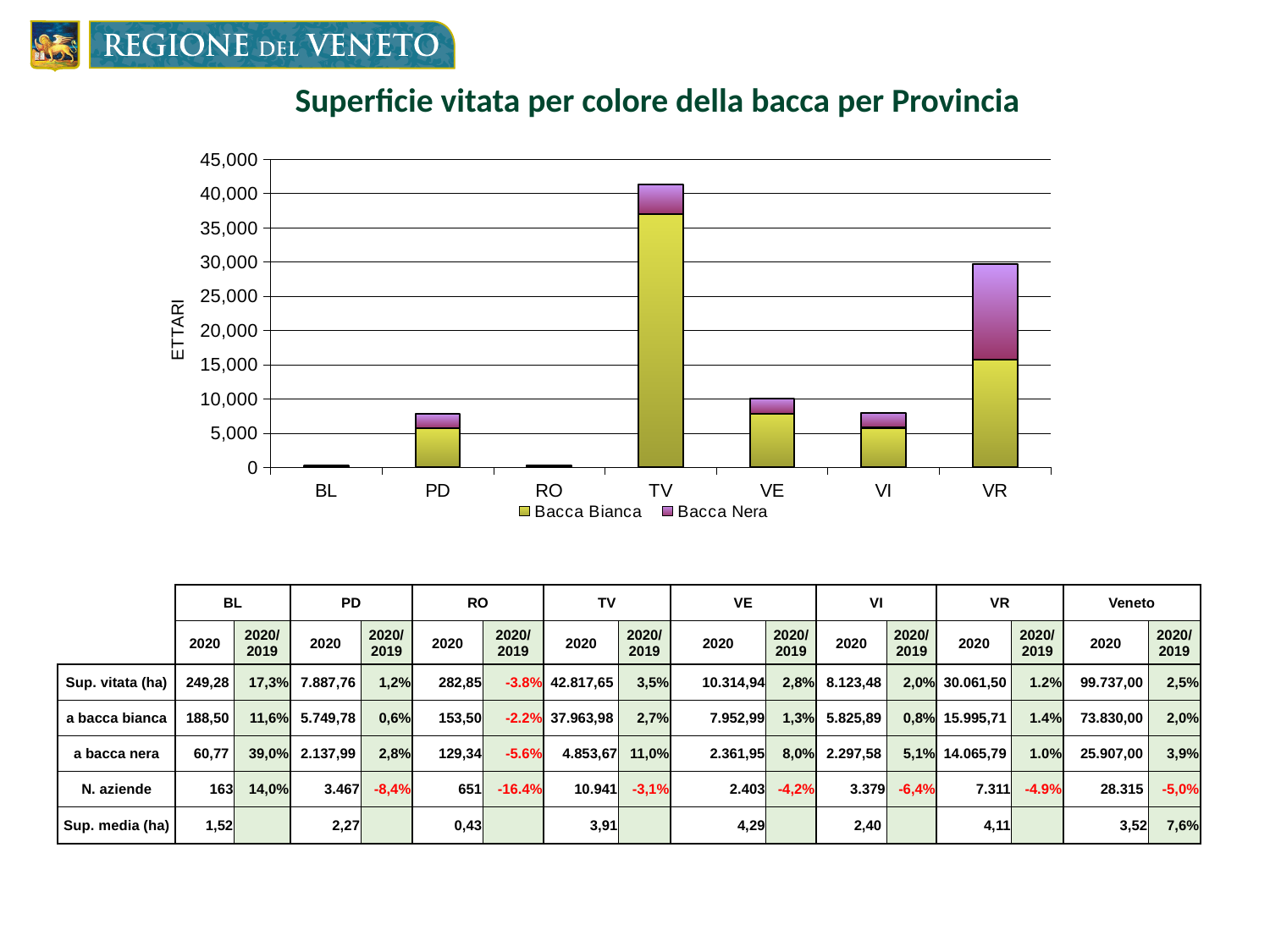
What kind of chart is shown on the slide? Stacked bar chart How many series does the chart legend list? 2 Which bar is taller, VE or VI? VE Is the total bar for VE greater or less than 15,000? less Which two series are listed in the chart legend? Bacca Bianca and Bacca Nera Is the total bar for VR greater or less than 25,000? greater Is the total bar for TV greater or less than 40,000? greater Which province has the largest Bacca Nera segment in the chart? VR What is the label on the vertical axis of the chart? ETTARI Which province has the tallest bar in the chart? TV According to the table, what is the Sup. vitata (ha) for TV in 2020? 42.817,65 How many provinces are shown on the x axis of the chart? 7